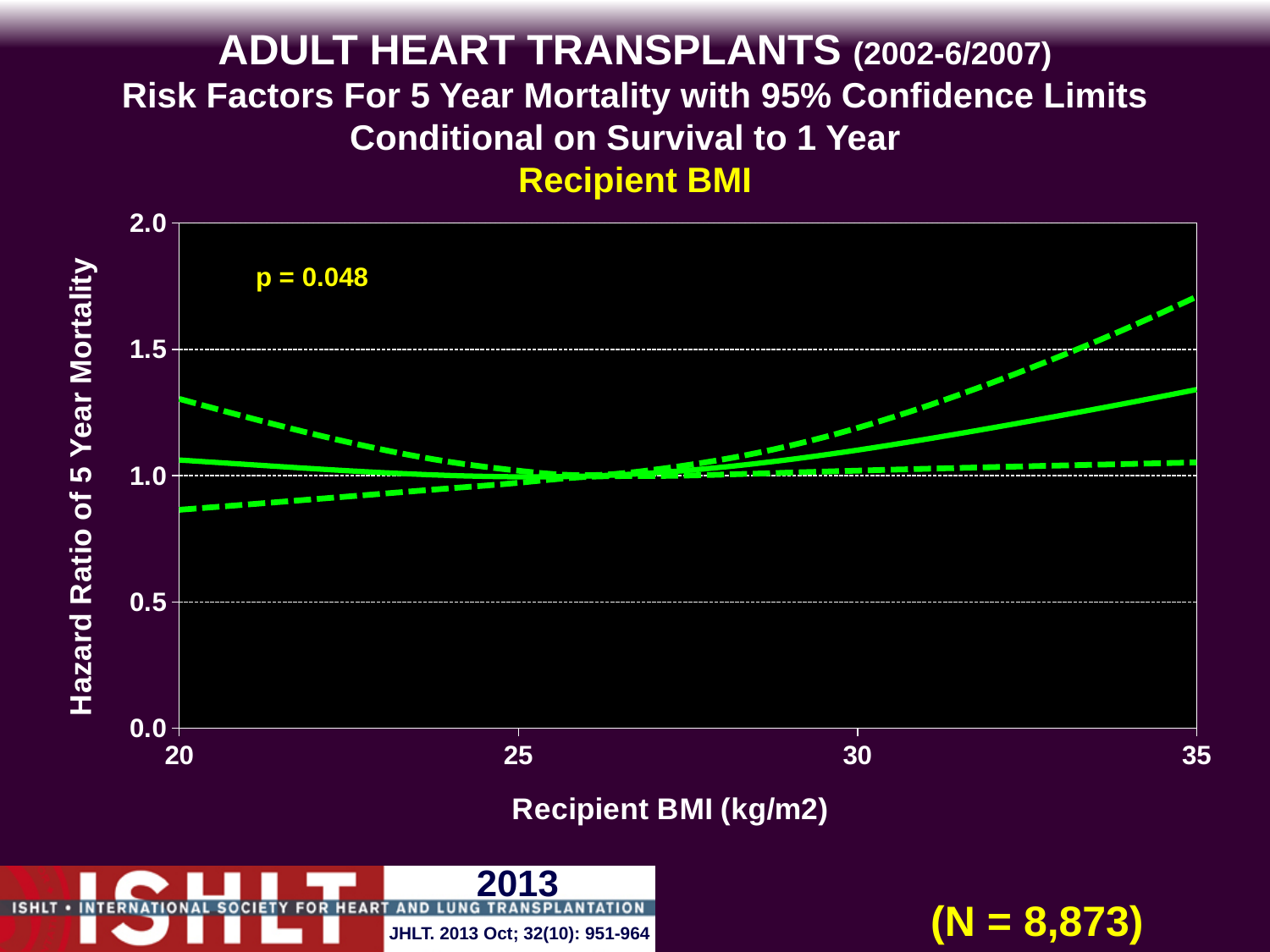
What is the sample size (N) shown on the slide? N = 8,873 Is the upper dashed confidence limit at a recipient BMI of 30 greater or less than 1.0? greater How many tick labels are shown on the x axis? 4 Is the solid hazard ratio line at a recipient BMI of 35 greater or less than 1.5? less What is the p-value printed on the chart? p = 0.048 Does the upper dashed confidence limit rise or fall as recipient BMI increases from 20 to 25? fall What kind of chart is shown on the slide? line chart Is the upper dashed confidence limit at a recipient BMI of 20 greater or less than 1.0? greater How many lines are plotted on the chart? 3 Does the solid hazard ratio line rise or fall as recipient BMI increases from 25 to 35? rise